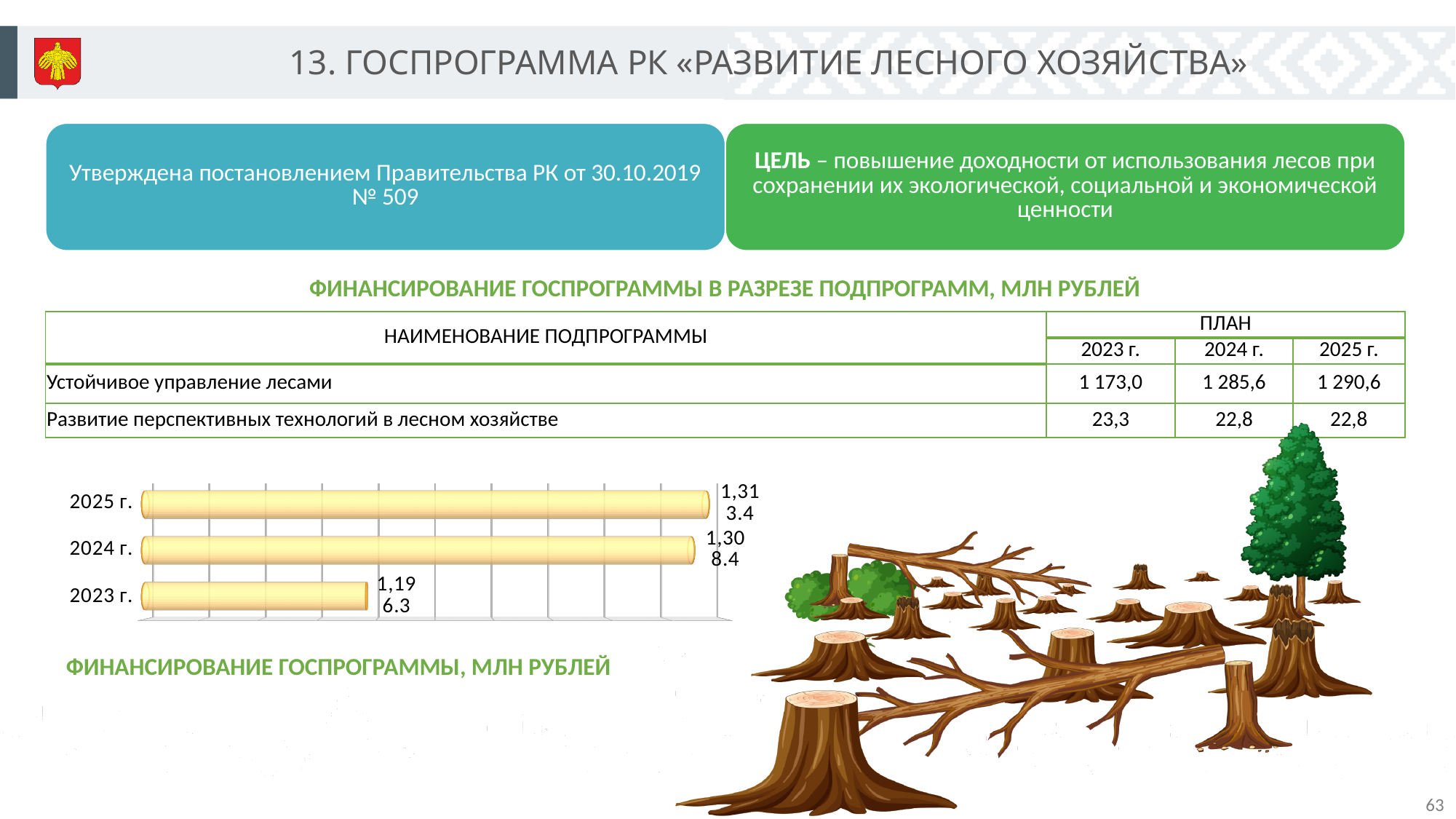
In the chart titled «ФИНАНСИРОВАНИЕ ГОСПРОГРАММЫ, МЛН РУБЛЕЙ», how many years are plotted? 3 In the chart titled «ФИНАНСИРОВАНИЕ ГОСПРОГРАММЫ, МЛН РУБЛЕЙ», which year has the lowest value? 2023 г. In the chart titled «ФИНАНСИРОВАНИЕ ГОСПРОГРАММЫ, МЛН РУБЛЕЙ», what is the value for 2023 г.? 1,196.3 In the chart titled «ФИНАНСИРОВАНИЕ ГОСПРОГРАММЫ, МЛН РУБЛЕЙ», do the values rise or fall from 2023 г. to 2025 г.? Rise In the chart titled «ФИНАНСИРОВАНИЕ ГОСПРОГРАММЫ, МЛН РУБЛЕЙ», what is the difference between the values for 2025 г. and 2024 г.? 5.0 In the chart titled «ФИНАНСИРОВАНИЕ ГОСПРОГРАММЫ, МЛН РУБЛЕЙ», which is larger: the value for 2024 г. or for 2023 г.? 2024 г. In the chart titled «ФИНАНСИРОВАНИЕ ГОСПРОГРАММЫ, МЛН РУБЛЕЙ», what is the value for 2024 г.? 1,308.4 In the chart titled «ФИНАНСИРОВАНИЕ ГОСПРОГРАММЫ, МЛН РУБЛЕЙ», which year has the highest value? 2025 г. In the chart titled «ФИНАНСИРОВАНИЕ ГОСПРОГРАММЫ, МЛН РУБЛЕЙ», what is the difference between the values for 2024 г. and 2023 г.? 112.1 What is the title of the bar chart on the slide? ФИНАНСИРОВАНИЕ ГОСПРОГРАММЫ, МЛН РУБЛЕЙ What kind of chart is the one titled «ФИНАНСИРОВАНИЕ ГОСПРОГРАММЫ, МЛН РУБЛЕЙ»? Bar chart In the chart titled «ФИНАНСИРОВАНИЕ ГОСПРОГРАММЫ, МЛН РУБЛЕЙ», what is the value for 2025 г.? 1,313.4